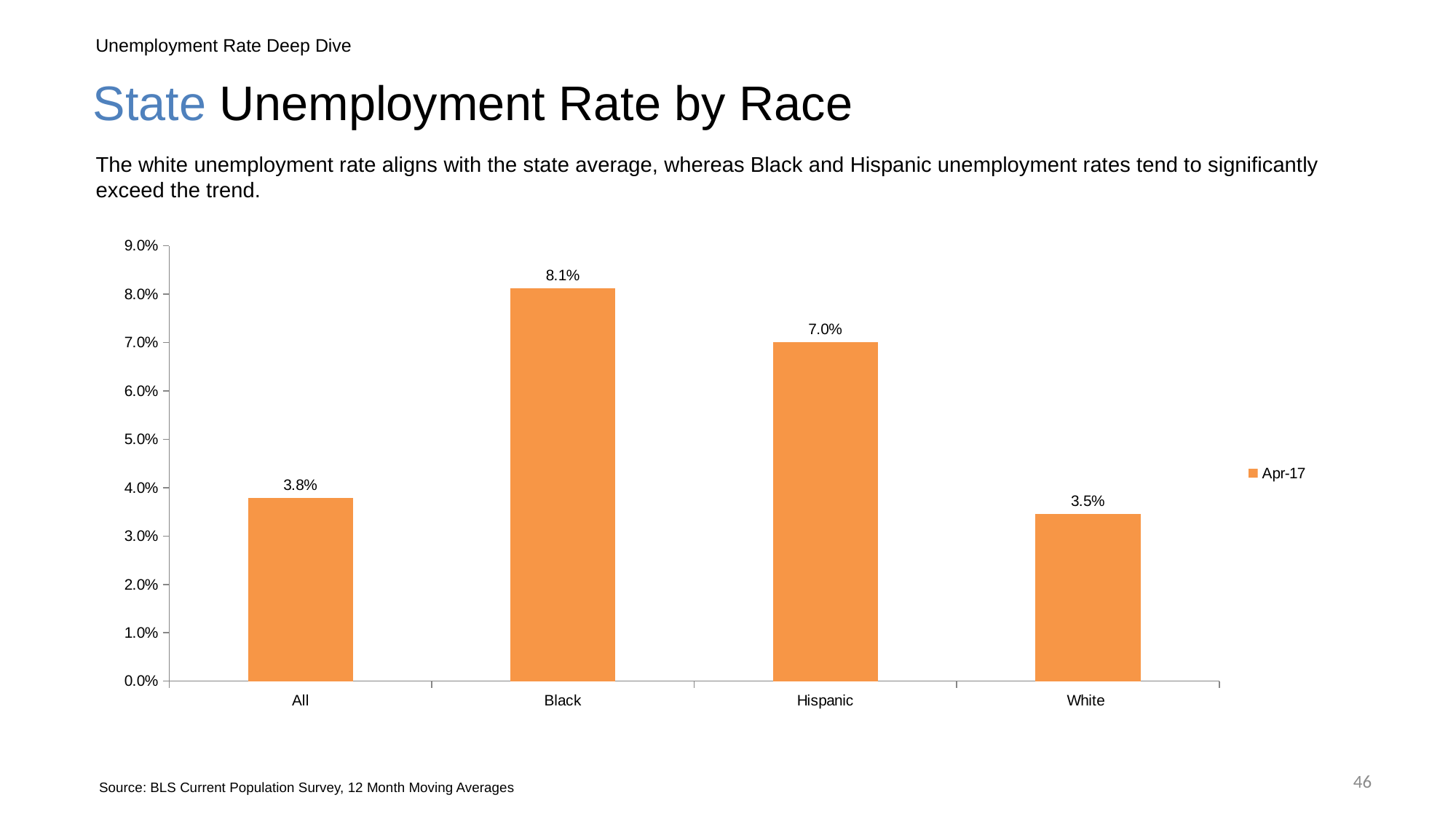
What is the unemployment rate for White? 3.5% Which category has the lowest unemployment rate? White What is the difference between the Hispanic and All unemployment rates? 3.2% What is the unemployment rate for All? 3.8% What is the difference between the Black and White unemployment rates? 4.6% How many categories are shown on the x axis? 4 Which category has the highest unemployment rate? Black Which is larger, the unemployment rate for Hispanic or for All? Hispanic What is the unemployment rate for Hispanic? 7.0% What series does the legend list? Apr-17 What kind of chart is shown on the slide? Bar chart What is the unemployment rate for Black? 8.1%